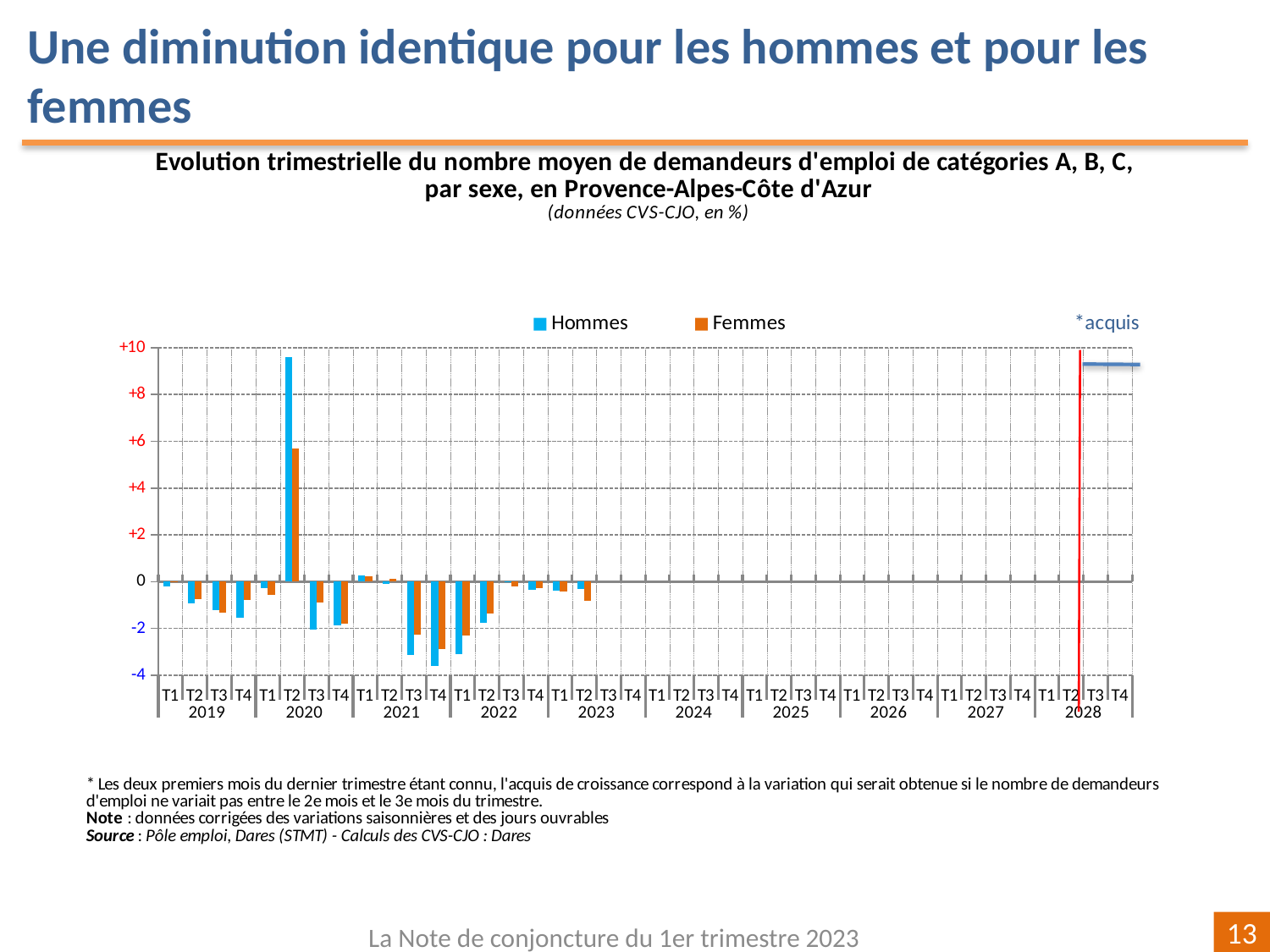
In which quarter does the Hommes series reach its highest value? T2 2020 How many series does the legend list? 2 Is the value for Hommes in T4 2021 greater or less than -2? less How many years are labelled along the x axis? 10 In which quarter does the Hommes series reach its lowest value? T4 2021 In T2 2020, which series has the larger value, Hommes or Femmes? Hommes Is the value for Femmes in T2 2020 greater or less than +4? greater What kind of chart is shown on the slide? bar chart What colour are the bars for the Femmes series? orange Is the value for Hommes in T2 2020 greater or less than +8? greater Which two series are shown in the legend? Hommes and Femmes